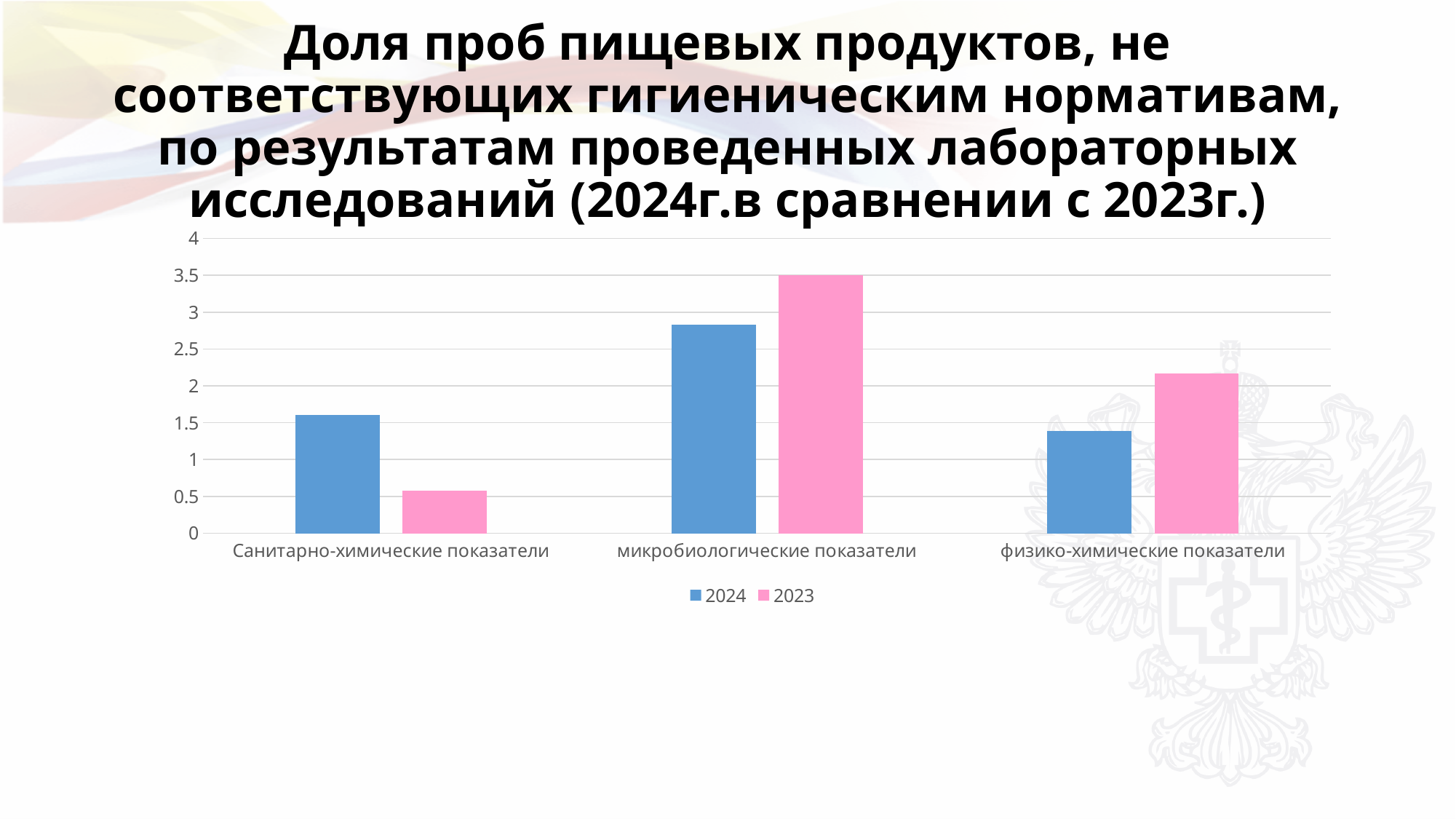
How many categories are shown on the x axis? 3 Which category has the highest value for the 2023 series? микробиологические показатели For физико-химические показатели, which year has the larger value, 2024 or 2023? 2023 Is the 2023 value for Санитарно-химические показатели greater or less than 1? less Which category has the lowest value for the 2023 series? Санитарно-химические показатели Is the 2024 value for физико-химические показатели greater or less than 1.5? less What kind of chart is shown on the slide? bar chart Which category has the highest value for the 2024 series? микробиологические показатели For Санитарно-химические показатели, which year has the larger value, 2024 or 2023? 2024 How many series does the legend list? 2 Is the 2024 value for микробиологические показатели greater or less than 2.5? greater Which colour represents the 2023 series in the legend? pink